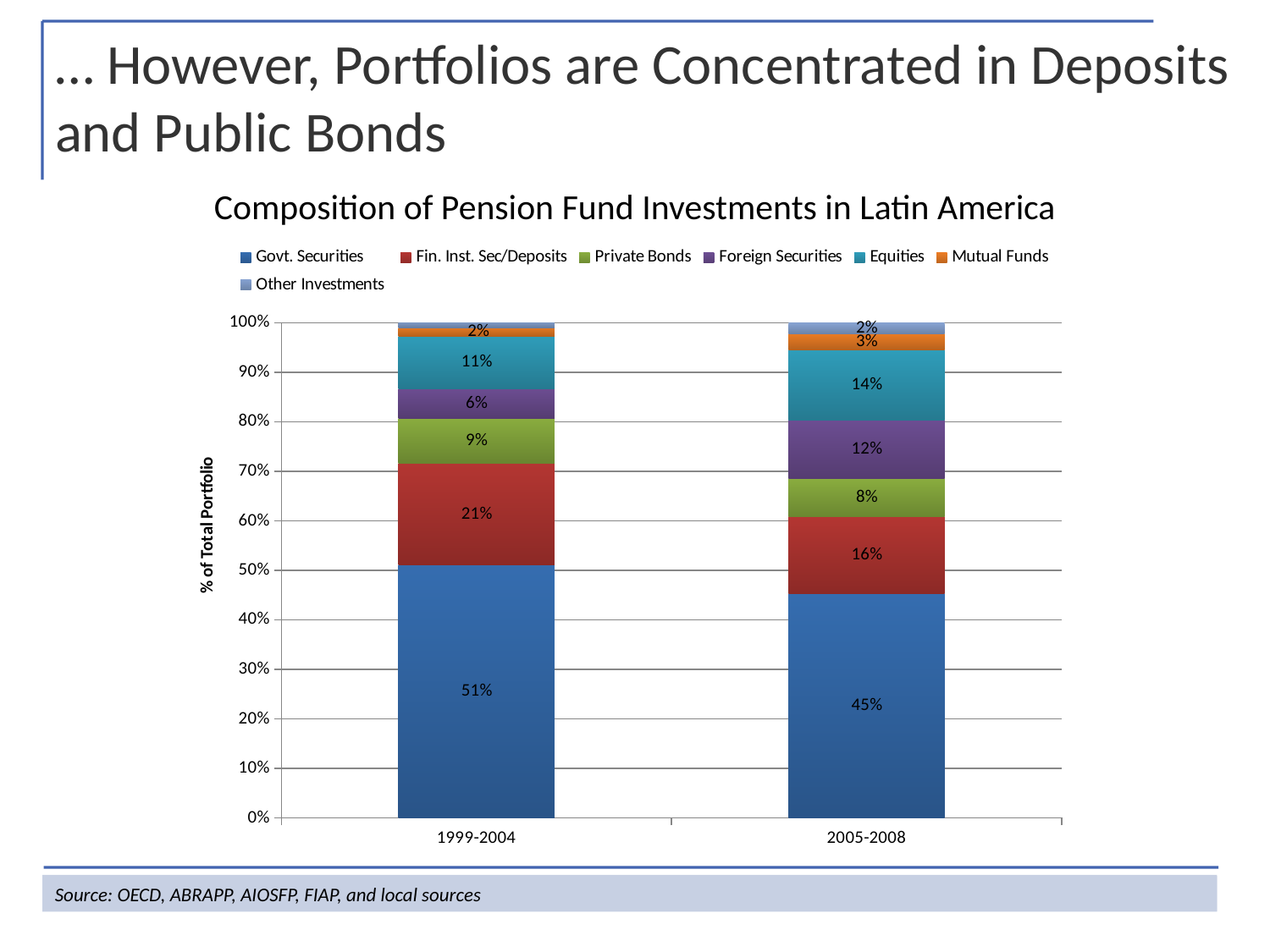
What share of the portfolio was in Foreign Securities in 2005-2008? 12% What kind of chart is shown on the slide? Stacked bar chart What share of the portfolio was in Govt. Securities in 2005-2008? 45% What share of the portfolio was in Govt. Securities in 1999-2004? 51% How many time periods are shown on the x axis? 2 By how many percentage points did the Govt. Securities share fall from 1999-2004 to 2005-2008? 6 percentage points Which period had the larger share in Private Bonds, 1999-2004 or 2005-2008? 1999-2004 Which investment category makes up the largest share of the 2005-2008 portfolio? Govt. Securities How many series does the legend list? 7 Did the share of Foreign Securities rise or fall from 1999-2004 to 2005-2008? Rise What share of the portfolio was in Equities in 2005-2008? 14% What share of the portfolio was in Fin. Inst. Sec/Deposits in 1999-2004? 21%